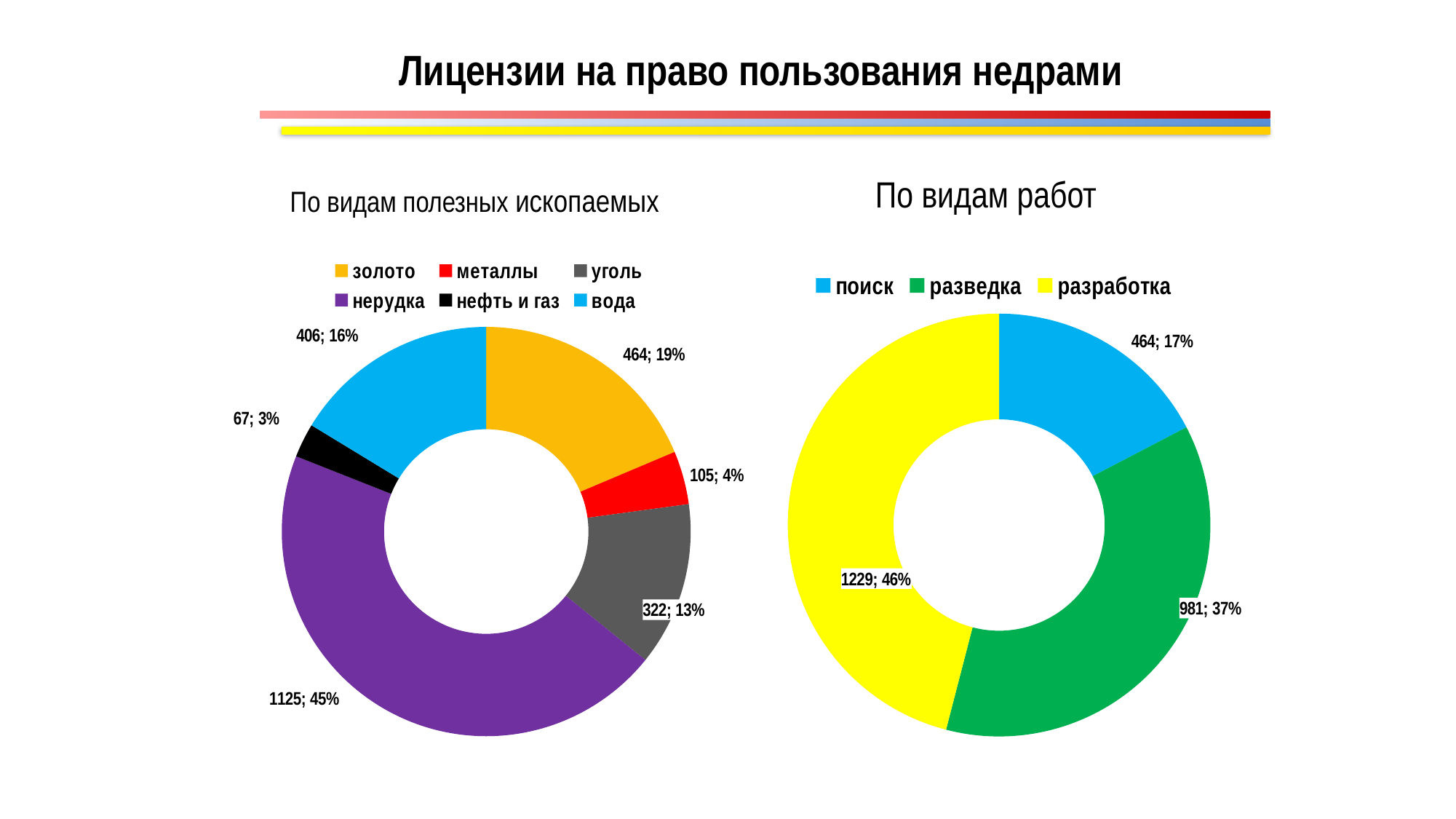
How many categories does the chart 'По видам полезных ископаемых' show? 6 In the chart 'По видам работ', what is the difference between the values for разработка and поиск? 765 In the chart 'По видам полезных ископаемых', which category has the smallest value? нефть и газ In the chart 'По видам работ', what share of the total does разработка have? 46% In the chart 'По видам полезных ископаемых', which category has the largest value? нерудка In the chart 'По видам работ', how many licences are shown for разведка? 981 In the chart 'По видам полезных ископаемых', what is the difference between the values for вода and уголь? 84 In the chart 'По видам полезных ископаемых', which is larger: металлы or уголь? уголь In the chart 'По видам полезных ископаемых', how many licences are shown for нерудка? 1125 In the chart 'По видам работ', which colour represents поиск? Blue What type of chart is used for 'По видам работ'? Doughnut (pie) chart In the chart 'По видам полезных ископаемых', what share of the total does золото have? 19%